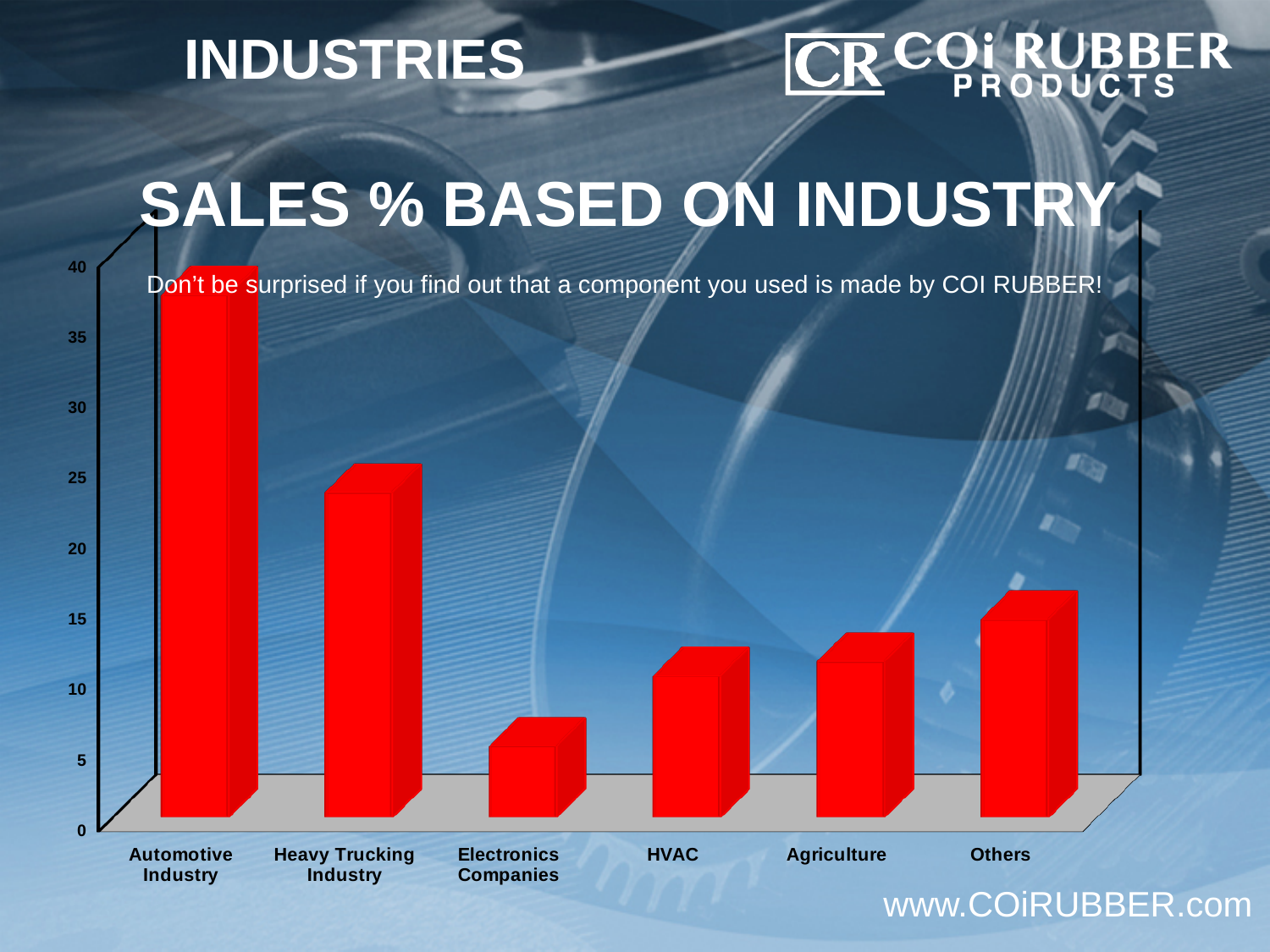
What is the title of the chart? SALES % BASED ON INDUSTRY What colour are the bars in the chart? red What type of chart is shown on the slide? bar chart How many industry categories are shown in the chart? 6 Is the value for Electronics Companies greater or less than 10? less Is the value for Automotive Industry greater or less than 35? greater Which industry has the lowest sales percentage? Electronics Companies Is the value for Others greater or less than 20? less Which industry has the highest sales percentage? Automotive Industry Which has a higher sales percentage, Electronics Companies or HVAC? HVAC Which has a higher sales percentage, Automotive Industry or Heavy Trucking Industry? Automotive Industry